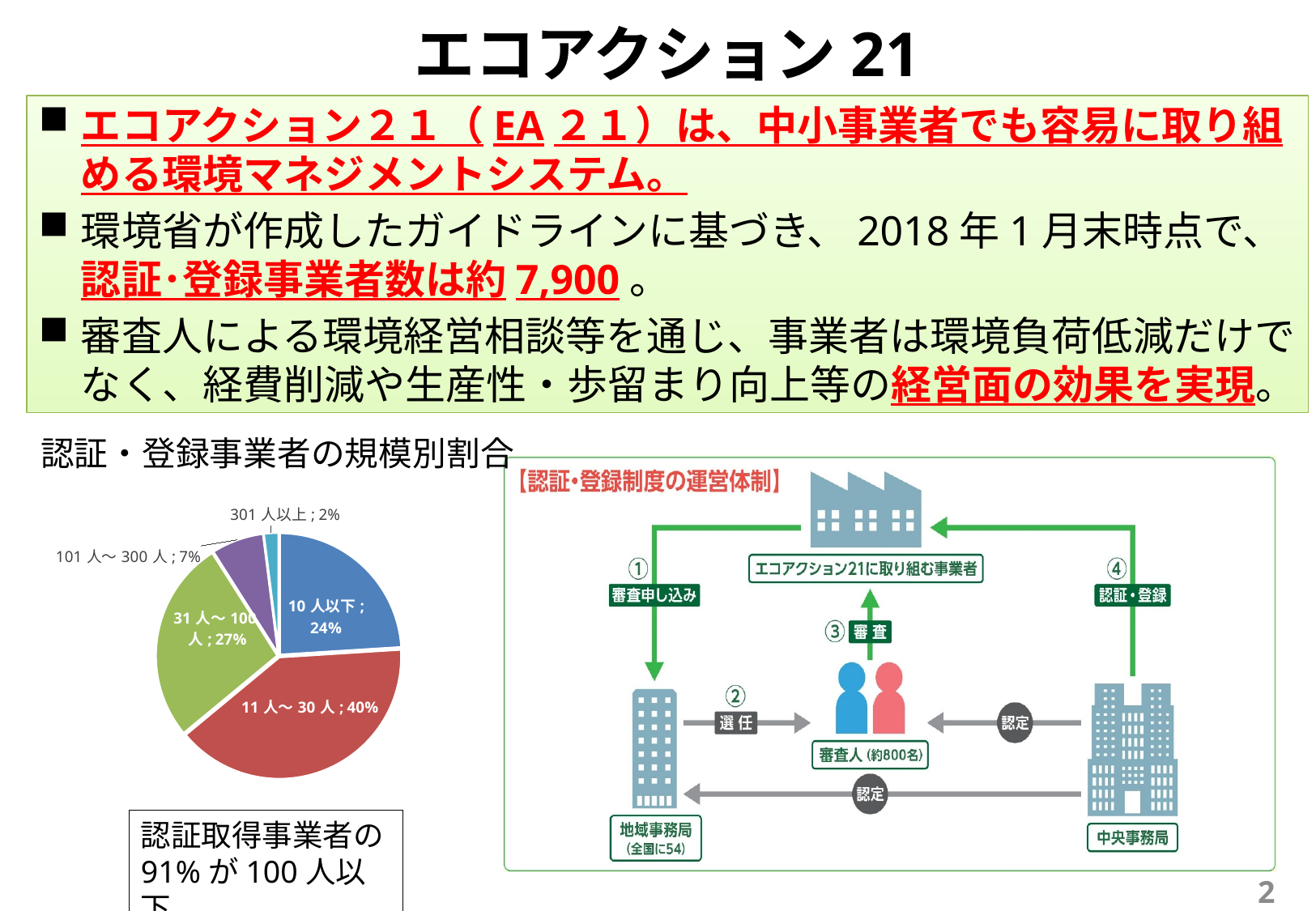
In the pie chart, what share do businesses with 301人以上 have? 2% Which size category has the largest share in the pie chart? 11人～30人 In the pie chart, what is the difference in share between 11人～30人 and 10人以下? 16% In the pie chart, what share do businesses with 31人～100人 have? 27% How many size categories are shown in the pie chart? 5 In the pie chart, what share do businesses with 10人以下 have? 24% In the pie chart, which has the larger share: 31人～100人 or 10人以下? 31人～100人 What kind of chart is used to show 認証・登録事業者の規模別割合? pie chart Which size category has the smallest share in the pie chart? 301人以上 What is the title of the pie chart on the slide? 認証・登録事業者の規模別割合 In the pie chart, what share do businesses with 11人～30人 have? 40% In the pie chart, what share do businesses with 101人～300人 have? 7%